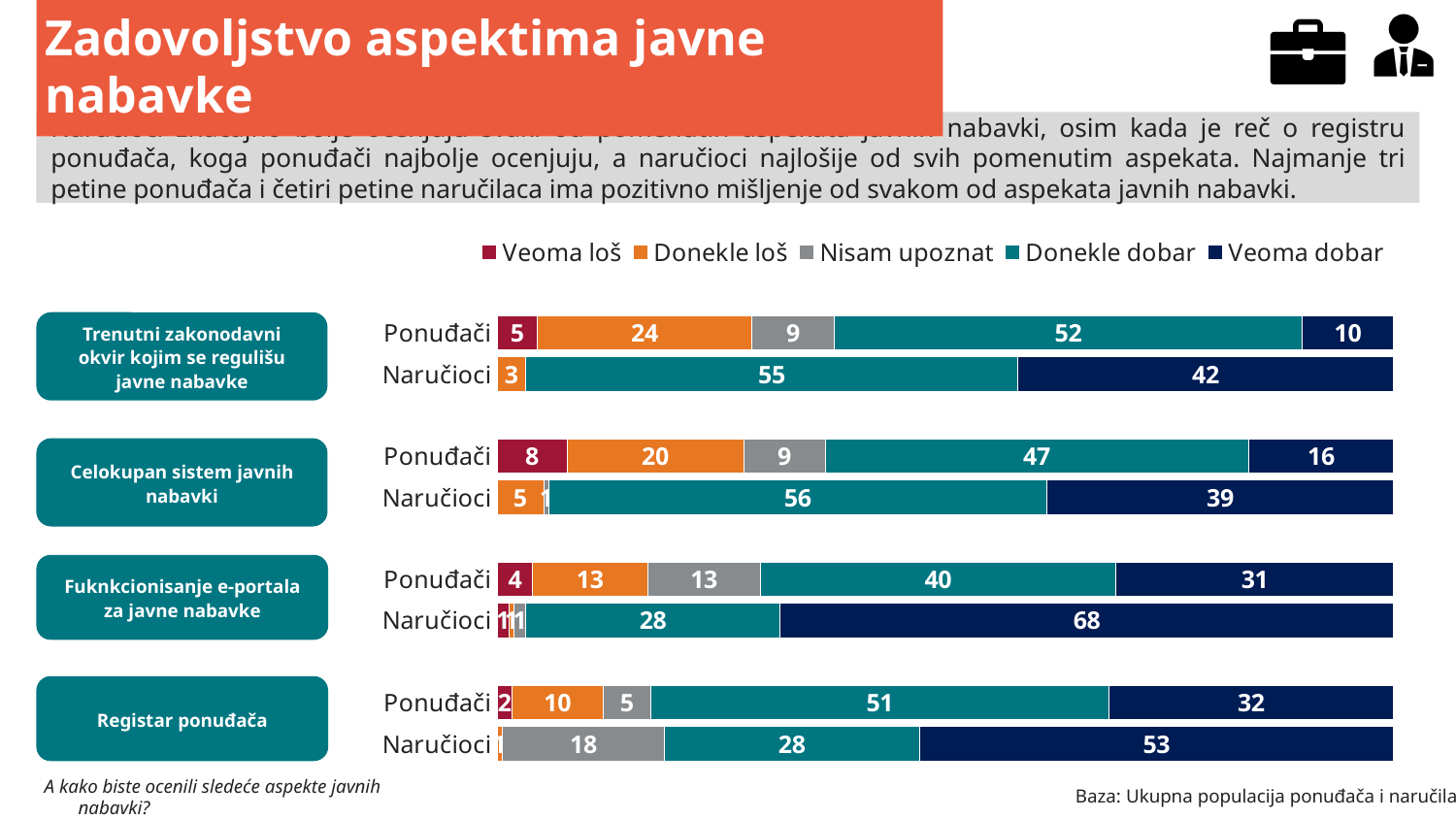
How many series does the legend list? 5 Which legend entry is shown in orange? Donekle loš What is the 'Veoma dobar' value for Naručioci on 'Fuknkcionisanje e-portala za javne nabavke'? 68 What is the 'Donekle dobar' value for Ponuđači on 'Trenutni zakonodavni okvir kojim se regulišu javne nabavke'? 52 What is the difference between the 'Veoma dobar' values for Naručioci and Ponuđači on 'Trenutni zakonodavni okvir kojim se regulišu javne nabavke'? 32 Which aspect has the highest 'Veoma dobar' value among Ponuđači? Registar ponuđača For 'Registar ponuđača', is the 'Donekle dobar' value larger for Ponuđači or Naručioci? Ponuđači What is the 'Donekle loš' value for Ponuđači on 'Celokupan sistem javnih nabavki'? 20 What is the 'Nisam upoznat' value for Naručioci on 'Registar ponuđača'? 18 Which aspect has the lowest 'Veoma dobar' value among Ponuđači? Trenutni zakonodavni okvir kojim se regulišu javne nabavke What kind of chart is shown on the slide? stacked bar chart How many aspects of public procurement are shown in the chart? 4